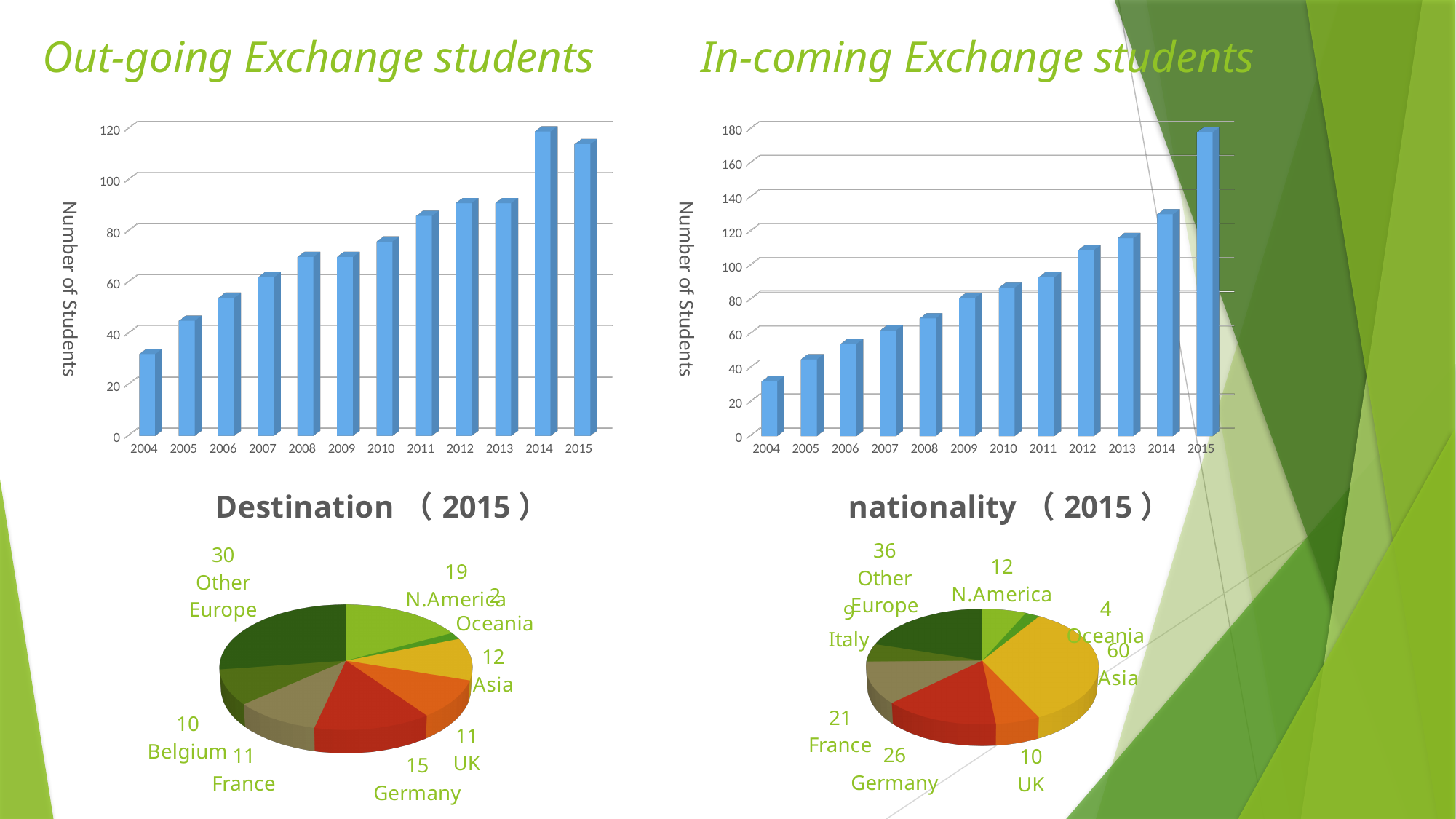
In the 'Destination (2015)' pie chart, which is larger, N.America or Asia? N.America What kind of chart is the 'Out-going Exchange students' chart? bar chart In the 'In-coming Exchange students' bar chart, is the value for 2015 greater or less than 160? greater In the 'In-coming Exchange students' bar chart, which year has the lowest number of students? 2004 How many years are shown on the x axis of the 'In-coming Exchange students' bar chart? 12 In the 'Out-going Exchange students' bar chart, which year has the highest number of students? 2014 In the 'Out-going Exchange students' bar chart, do the values generally rise or fall from 2004 to 2014? rise In the 'Out-going Exchange students' bar chart, is the value for 2015 greater or less than 100? greater In the 'nationality (2015)' pie chart, what is the difference between Other Europe and Germany? 10 In the 'Destination (2015)' pie chart, what is the value for Germany? 15 In the 'nationality (2015)' pie chart, what is the value for Asia? 60 In the 'In-coming Exchange students' bar chart, which year has the highest number of students? 2015